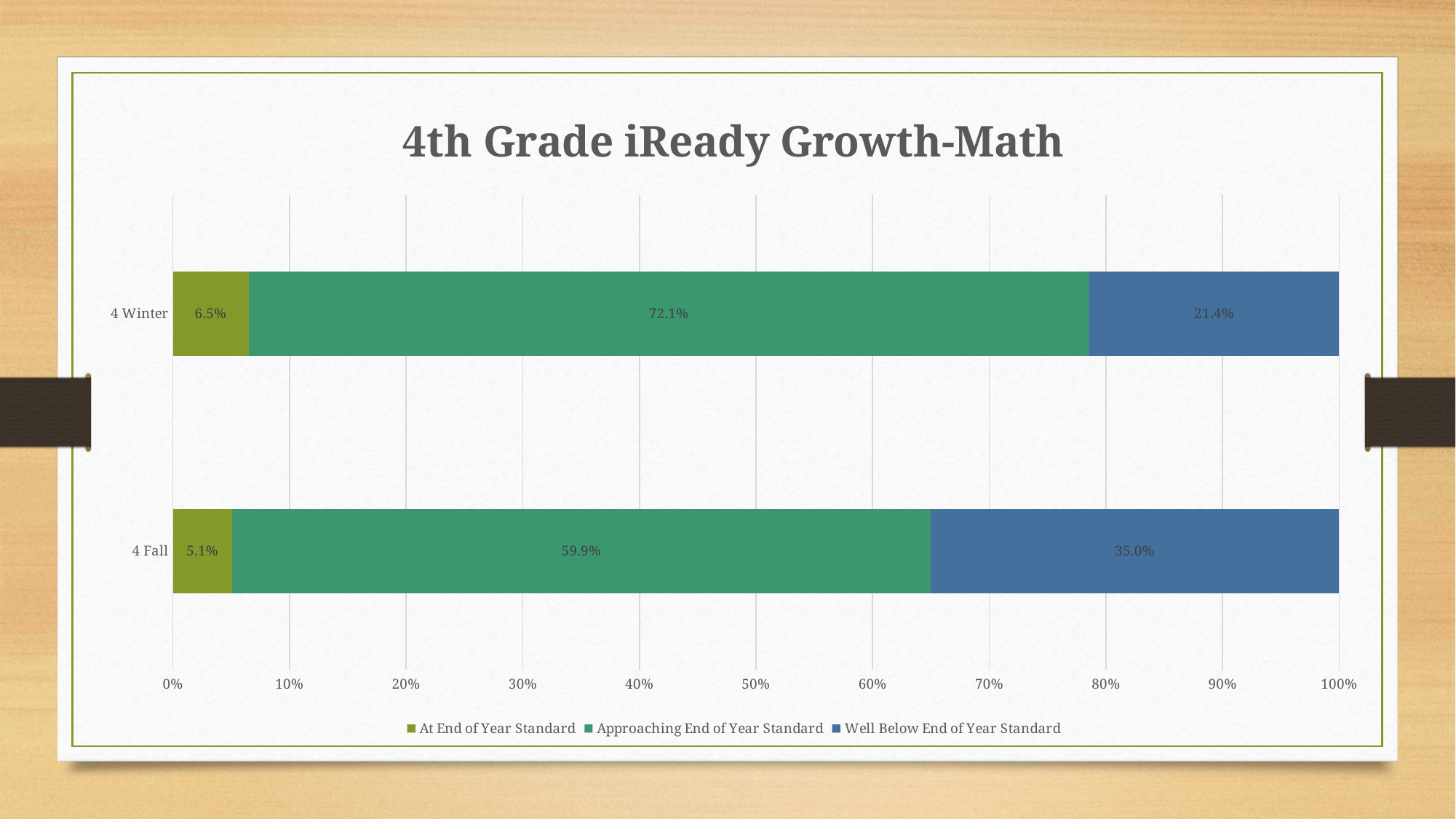
What kind of chart is shown on the slide? Stacked bar chart What is the title of the chart? 4th Grade iReady Growth-Math Which series is shown in blue in the legend? Well Below End of Year Standard What percentage of students were At End of Year Standard in 4 Fall? 5.1% What percentage of students were Well Below End of Year Standard in 4 Fall? 35.0% What percentage of students were Approaching End of Year Standard in 4 Winter? 72.1% What is the difference in the Well Below End of Year Standard share between 4 Fall and 4 Winter? 13.6% Which category has the higher Approaching End of Year Standard value, 4 Fall or 4 Winter? 4 Winter How many series does the legend list? 3 Which category has the lower At End of Year Standard value? 4 Fall How many categories are shown on the chart? 2 What is the total of the stacked bar for 4 Winter? 100.0%